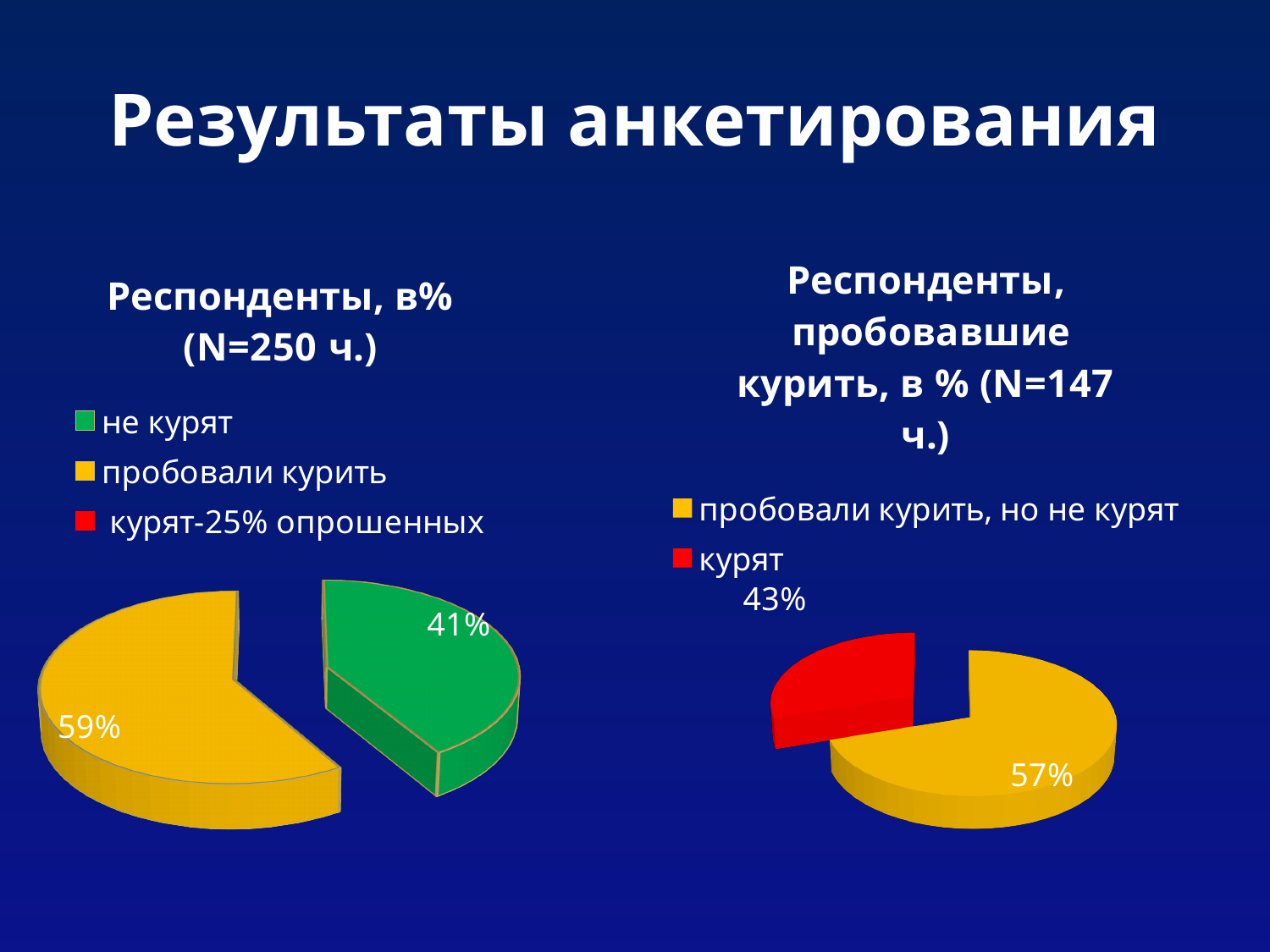
In the right chart (Респонденты, пробовавшие курить), what percentage is shown for 'пробовали курить, но не курят'? 57% How many entries does the legend of the right chart (Респонденты, пробовавшие курить) list? 2 In the right chart (Респонденты, пробовавшие курить), what is the difference between the 'пробовали курить, но не курят' and 'курят' slices? 14% In the left chart (Респонденты, в% (N=250 ч.)), what is the difference between the 'пробовали курить' and 'не курят' slices? 18% In the right chart (Респонденты, пробовавшие курить), which is larger: 'курят' or 'пробовали курить, но не курят'? пробовали курить, но не курят In the left chart (Респонденты, в% (N=250 ч.)), what percentage is shown for 'пробовали курить'? 59% In the right chart (Респонденты, пробовавшие курить), what colour is the 'курят' slice? Red In the right chart (Респонденты, пробовавшие курить), which slice is the smallest? курят In the left chart (Респонденты, в% (N=250 ч.)), which slice is the largest? пробовали курить In the right chart (Респонденты, пробовавшие курить), what percentage is shown for 'курят'? 43% What type of chart is the left chart (Респонденты, в% (N=250 ч.))? Pie chart In the left chart (Респонденты, в% (N=250 ч.)), what percentage is shown for 'не курят'? 41%